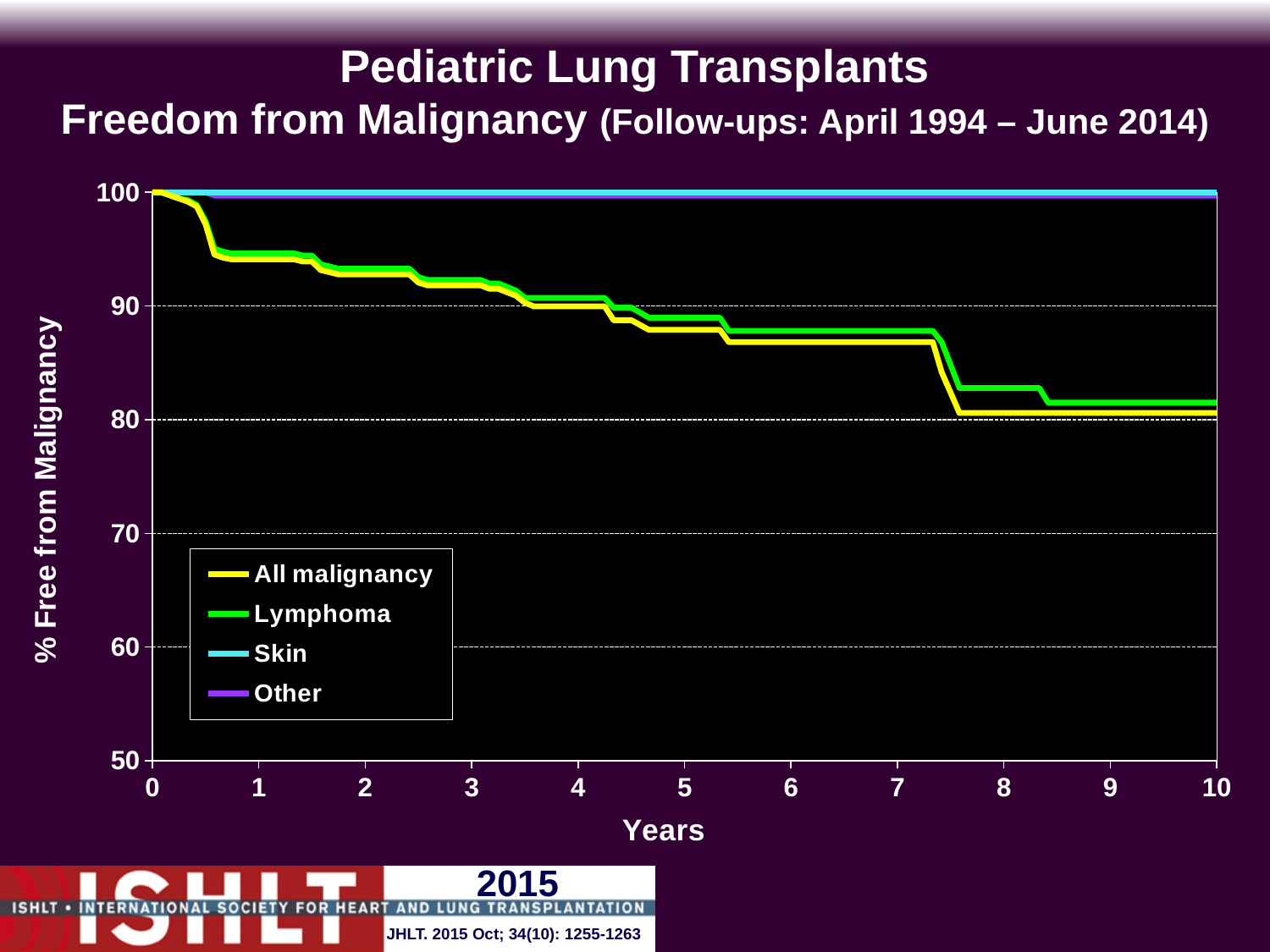
Is the value for Lymphoma at 2 years greater or less than 90? greater How many series does the legend list? 4 Is the value for Skin at 10 years greater or less than 90? greater What kind of chart is shown on the slide? line chart Which series has the lowest value at 10 years? All malignancy At 10 years, which is higher: Skin or All malignancy? Skin Is the value for All malignancy at 5 years greater or less than 80? greater Does the All malignancy curve rise or fall as years increase? fall What is the label of the y axis? % Free from Malignancy Which series is plotted in yellow? All malignancy At 8 years, which is higher: Lymphoma or All malignancy? Lymphoma